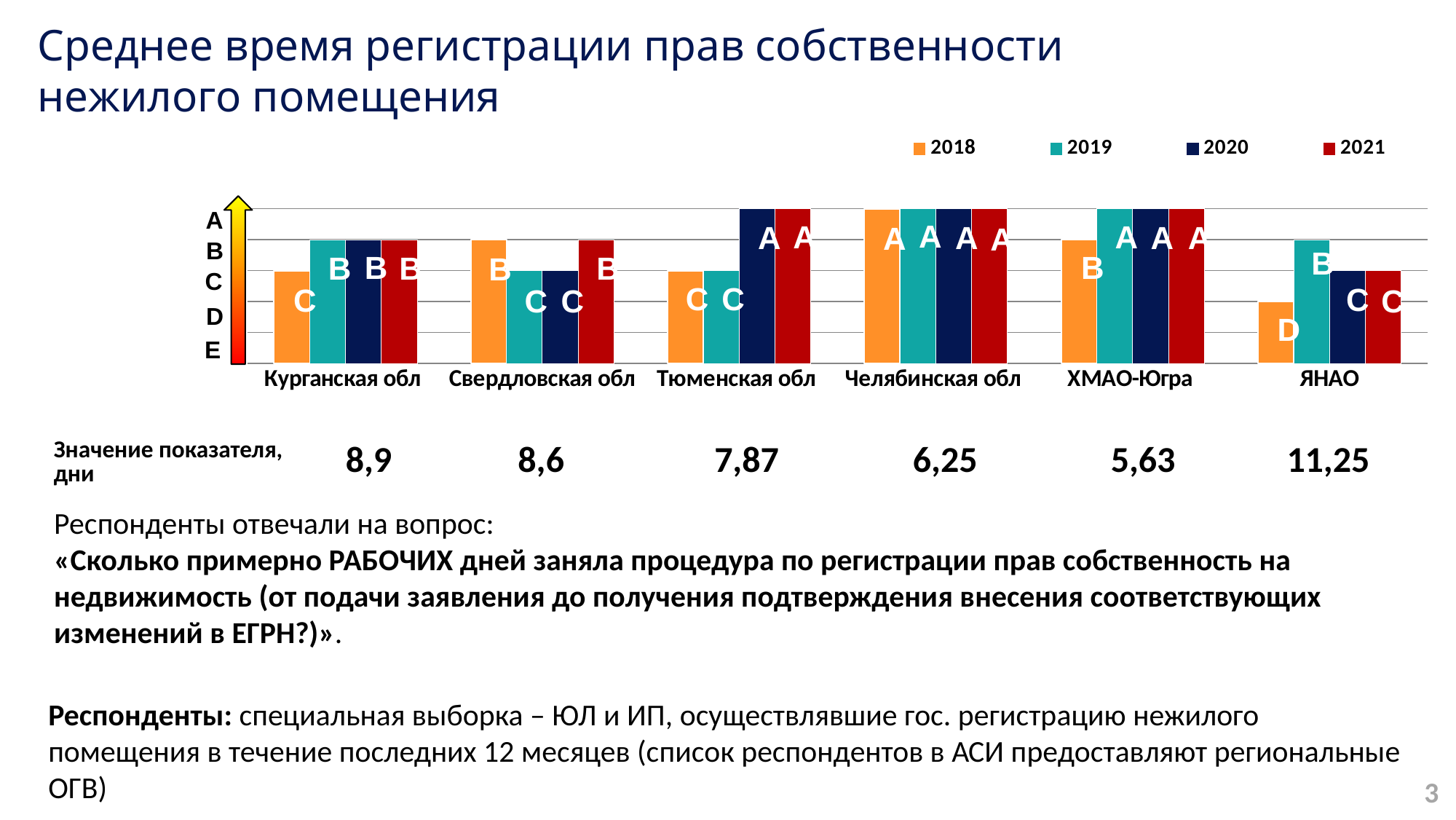
What is the indicator value in days (Значение показателя, дни) for Свердловская обл? 8,6 Which region has the lowest indicator value in days (Значение показателя, дни)? ХМАО-Югра Which region received grade A in all four years? Челябинская обл How many series (years) does the legend list? 4 Which region has the highest indicator value in days (Значение показателя, дни)? ЯНАО What grade is shown for ХМАО-Югра in 2018? B What grade is shown for ЯНАО in 2018? D How many regions are shown on the x axis of the chart? 6 What grade is shown for Курганская обл in 2018? C What is the difference between the indicator values in days for ЯНАО and ХМАО-Югра? 5,62 What grade is shown for Тюменская обл in 2021? A What type of chart is shown on the slide? Bar chart